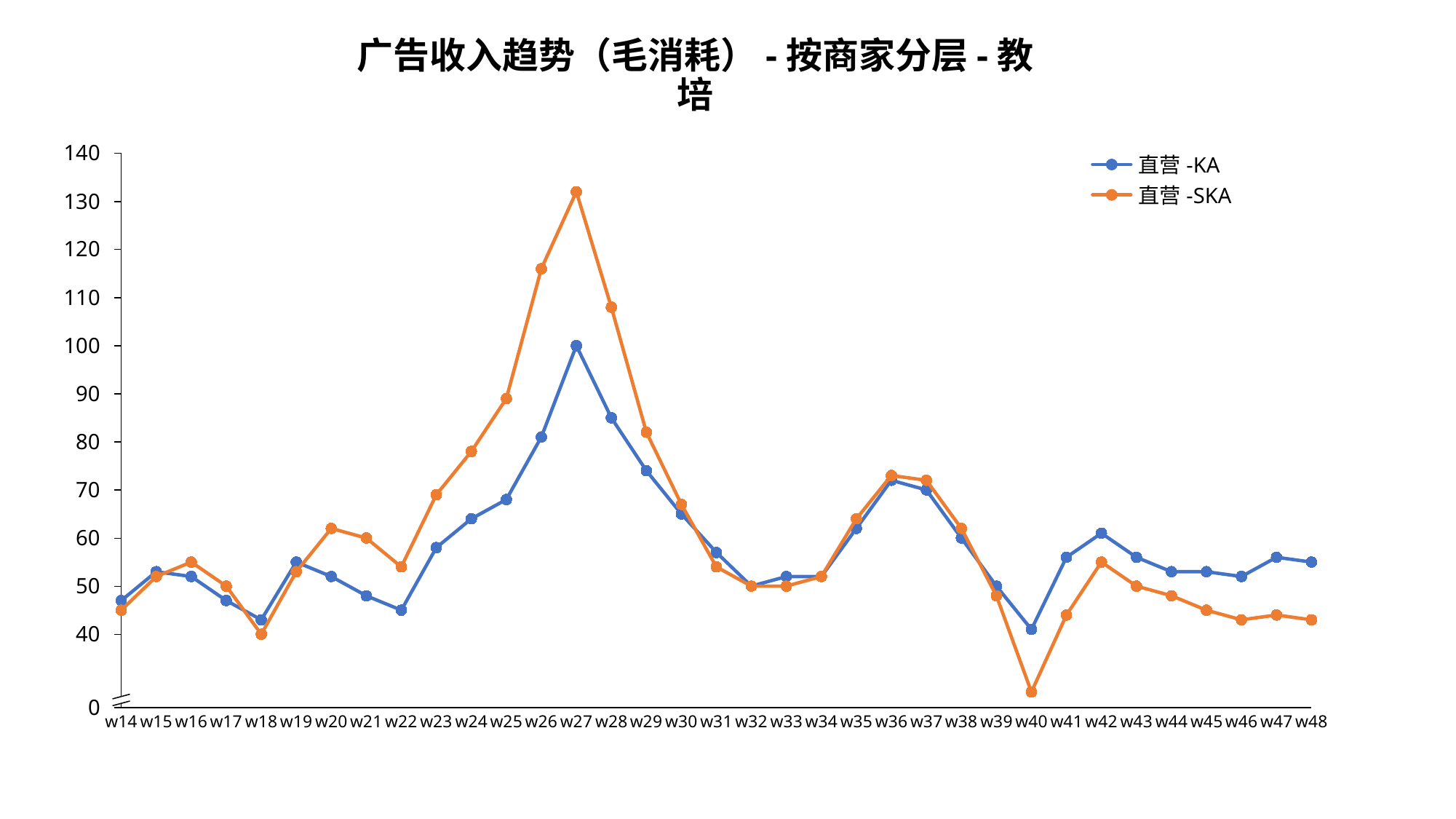
In which week does the 直营-SKA series reach its lowest value? w40 What is the value of 直营-KA at w27? 100 In which week does the 直营-SKA series reach its highest value? w27 Is the value for 直营-KA at w40 greater or less than 50? less Does the 直营-SKA series rise or fall from w27 to w32? fall How many weeks are plotted along the x axis? 35 How many series does the legend list? 2 What are the two series named in the legend? 直营-KA and 直营-SKA Is the value for 直营-SKA at w27 greater or less than 120? greater At w45, which series has the larger value, 直营-KA or 直营-SKA? 直营-KA What kind of chart is shown on the slide? line chart In which week does the 直营-KA series reach its highest value? w27